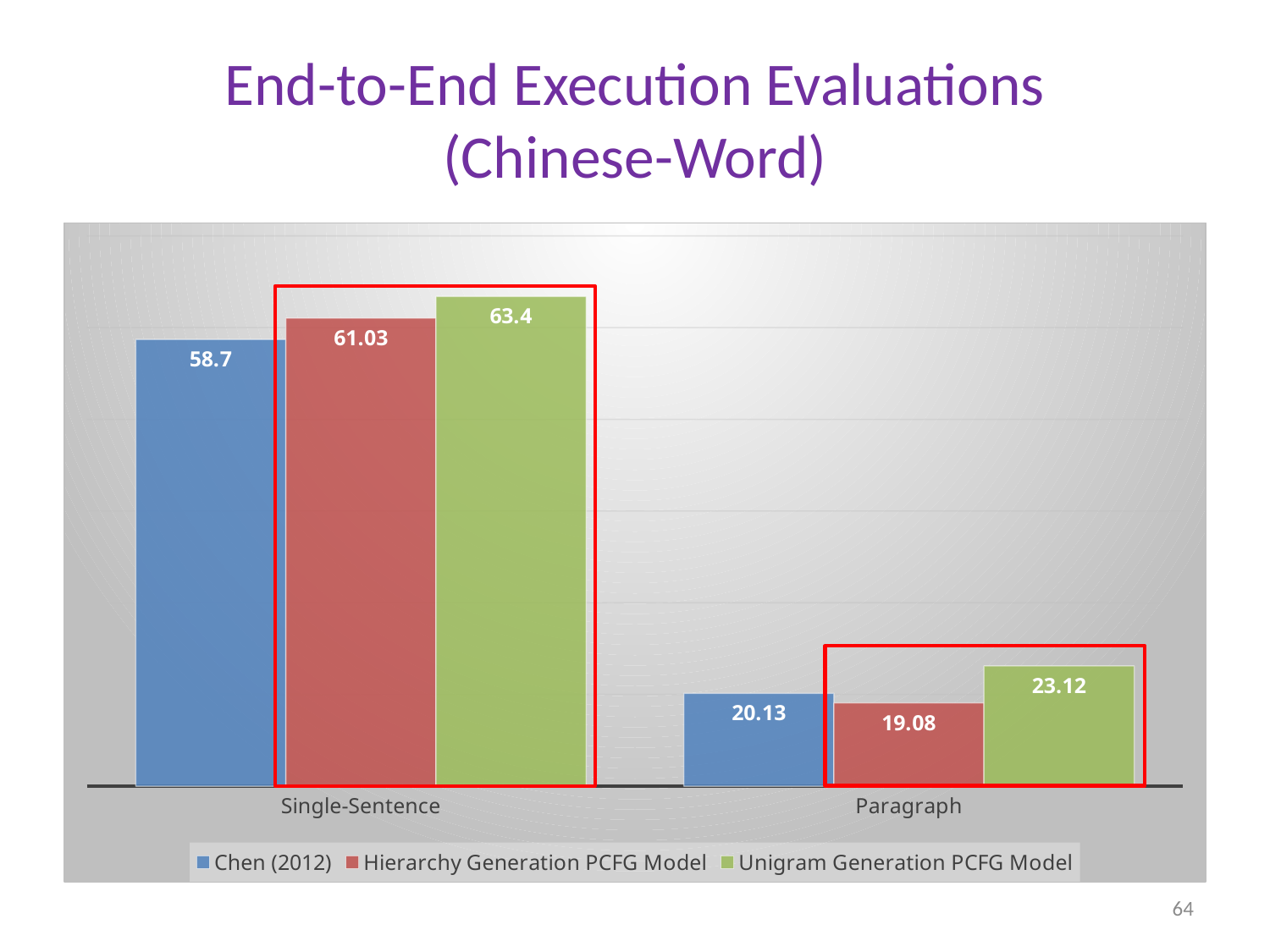
Which series has the lowest value in the Paragraph category? Hierarchy Generation PCFG Model Which is larger in the Paragraph category: Chen (2012) or the Hierarchy Generation PCFG Model? Chen (2012) What is the value for the Unigram Generation PCFG Model in the Paragraph category? 23.12 How many categories are shown on the x axis? 2 Which series has the highest value in the Single-Sentence category? Unigram Generation PCFG Model Which colour represents the Unigram Generation PCFG Model in the chart? Green How many series does the legend list? 3 What is the value for Chen (2012) in the Single-Sentence category? 58.7 What is the value for the Hierarchy Generation PCFG Model in the Single-Sentence category? 61.03 What kind of chart is shown on the slide? Bar chart What is the difference between the Unigram Generation PCFG Model and the Hierarchy Generation PCFG Model values in the Single-Sentence category? 2.37 What is the difference between the Unigram Generation PCFG Model and Chen (2012) values in the Paragraph category? 2.99